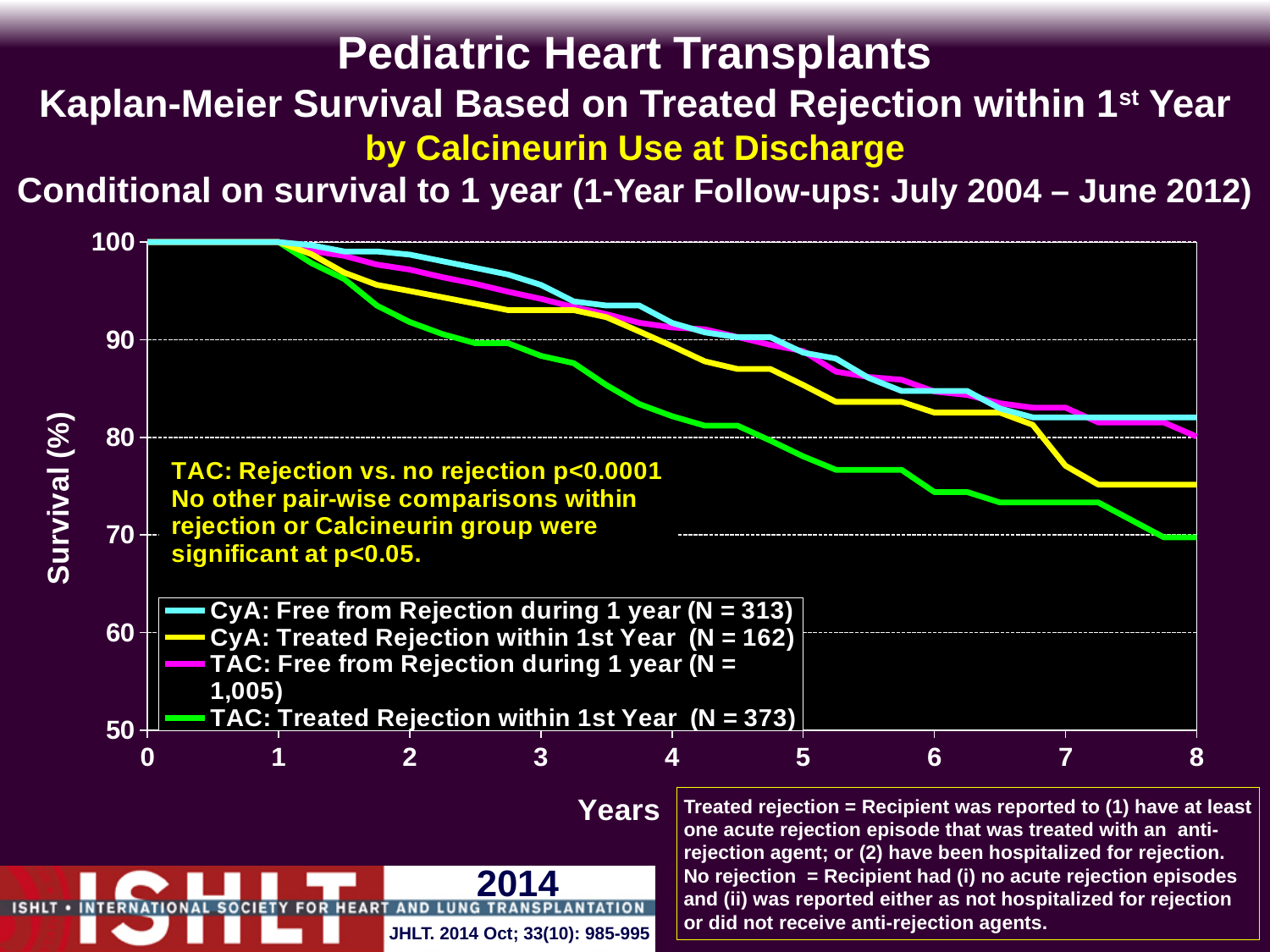
Which series has the lowest survival at 8 years? TAC: Treated Rejection within 1st Year What p-value is given for the TAC rejection vs. no rejection comparison? p<0.0001 Which series has the lowest survival at 4 years? TAC: Treated Rejection within 1st Year At 4 years, which is higher: the survival for CyA: Free from Rejection during 1 year or for TAC: Treated Rejection within 1st Year? CyA: Free from Rejection during 1 year Is the survival for CyA: Free from Rejection during 1 year at 2 years greater or less than 90? greater What is the N for the TAC: Free from Rejection during 1 year series in the legend? 1,005 Is the survival for CyA: Treated Rejection within 1st Year at 8 years greater or less than 80? less Is the survival for TAC: Treated Rejection within 1st Year at 6 years greater or less than 80? less Do the survival curves rise or fall as years increase? fall What kind of chart is shown on the slide? line chart How many series does the legend list? 4